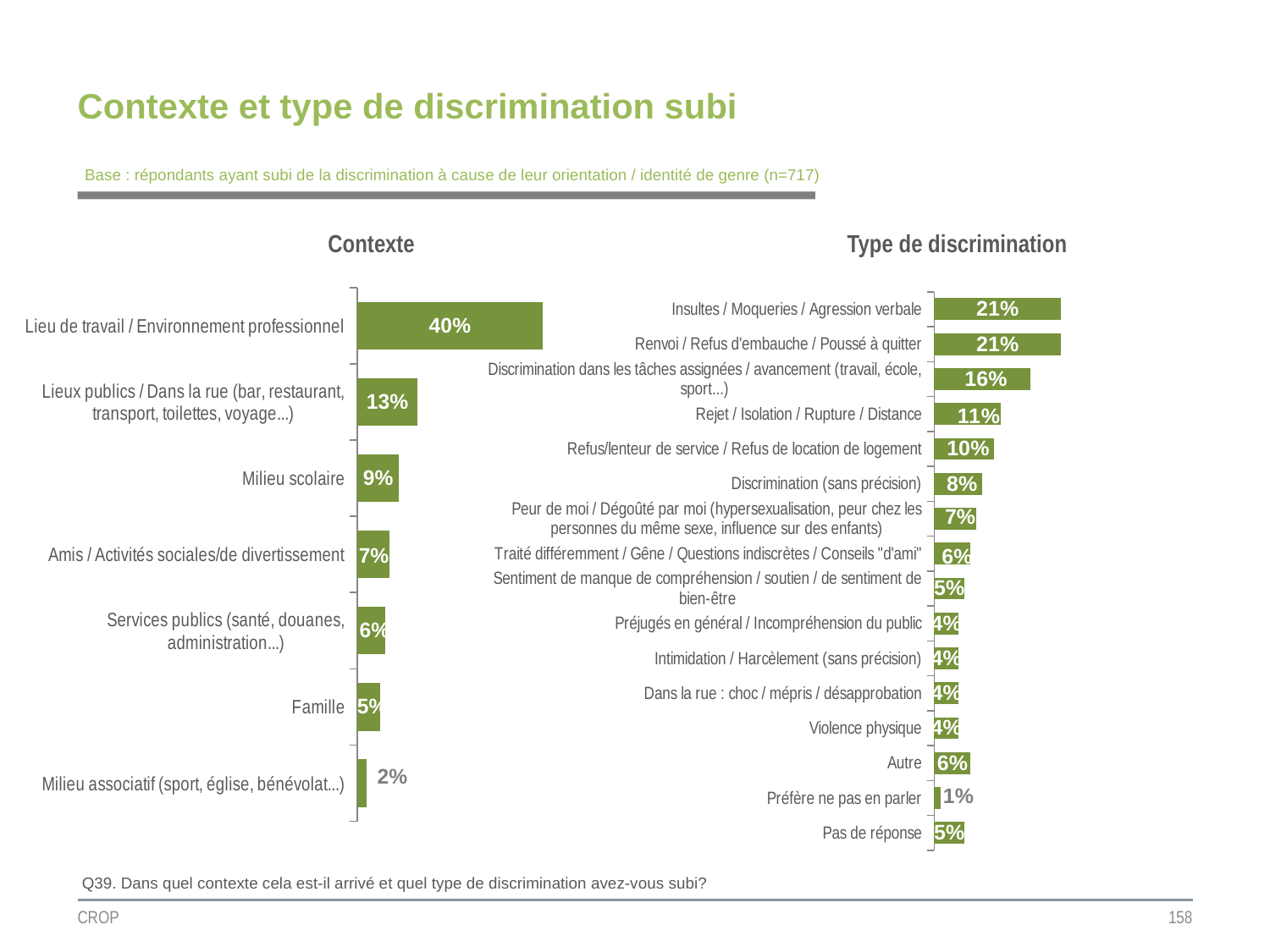
In the 'Contexte' chart, what is the difference between 'Lieu de travail / Environnement professionnel' and 'Lieux publics / Dans la rue (bar, restaurant, transport, toilettes, voyage...)'? 27% In the 'Contexte' chart, which category has the highest value? Lieu de travail / Environnement professionnel In the 'Type de discrimination' chart, what is the value for 'Rejet / Isolation / Rupture / Distance'? 11% How many categories are shown in the 'Contexte' chart? 7 In the 'Type de discrimination' chart, what is the value for 'Violence physique'? 4% In the 'Contexte' chart, what is the value for 'Lieu de travail / Environnement professionnel'? 40% In the 'Type de discrimination' chart, which is larger: 'Refus/lenteur de service / Refus de location de logement' or 'Discrimination (sans précision)'? Refus/lenteur de service / Refus de location de logement What type of chart is the 'Contexte' chart? Bar chart In the 'Contexte' chart, what is the value for 'Milieu scolaire'? 9% How many categories are shown in the 'Type de discrimination' chart? 16 In the 'Type de discrimination' chart, which category has the lowest value? Préfère ne pas en parler In the 'Contexte' chart, which category has the lowest value? Milieu associatif (sport, église, bénévolat...)